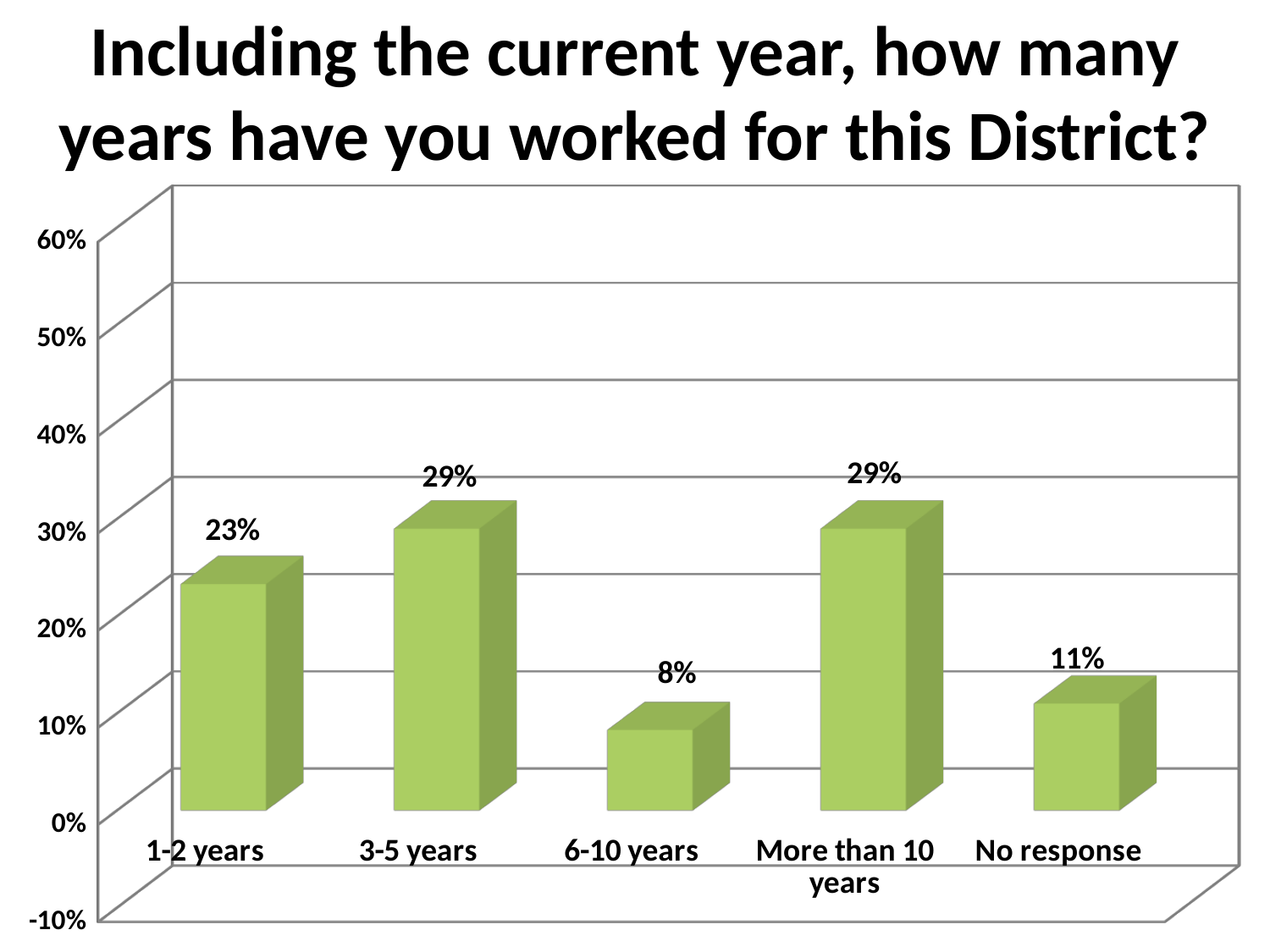
What is the value shown for the 6-10 years category? 8% What kind of chart is shown on the slide? bar chart Which is larger, the value for 1-2 years or the value for 3-5 years? 3-5 years What is the value for the More than 10 years category? 29% Is the value for 1-2 years greater or less than 20%? greater What is the difference between the 1-2 years value and the No response value? 12% What percentage is shown for No response? 11% Which category has the lowest value? 6-10 years What percentage of respondents have worked for the District for 1-2 years? 23% How many categories are shown on the x axis? 5 What is the title of the chart? Including the current year, how many years have you worked for this District? What is the difference between the 3-5 years value and the 6-10 years value? 21%